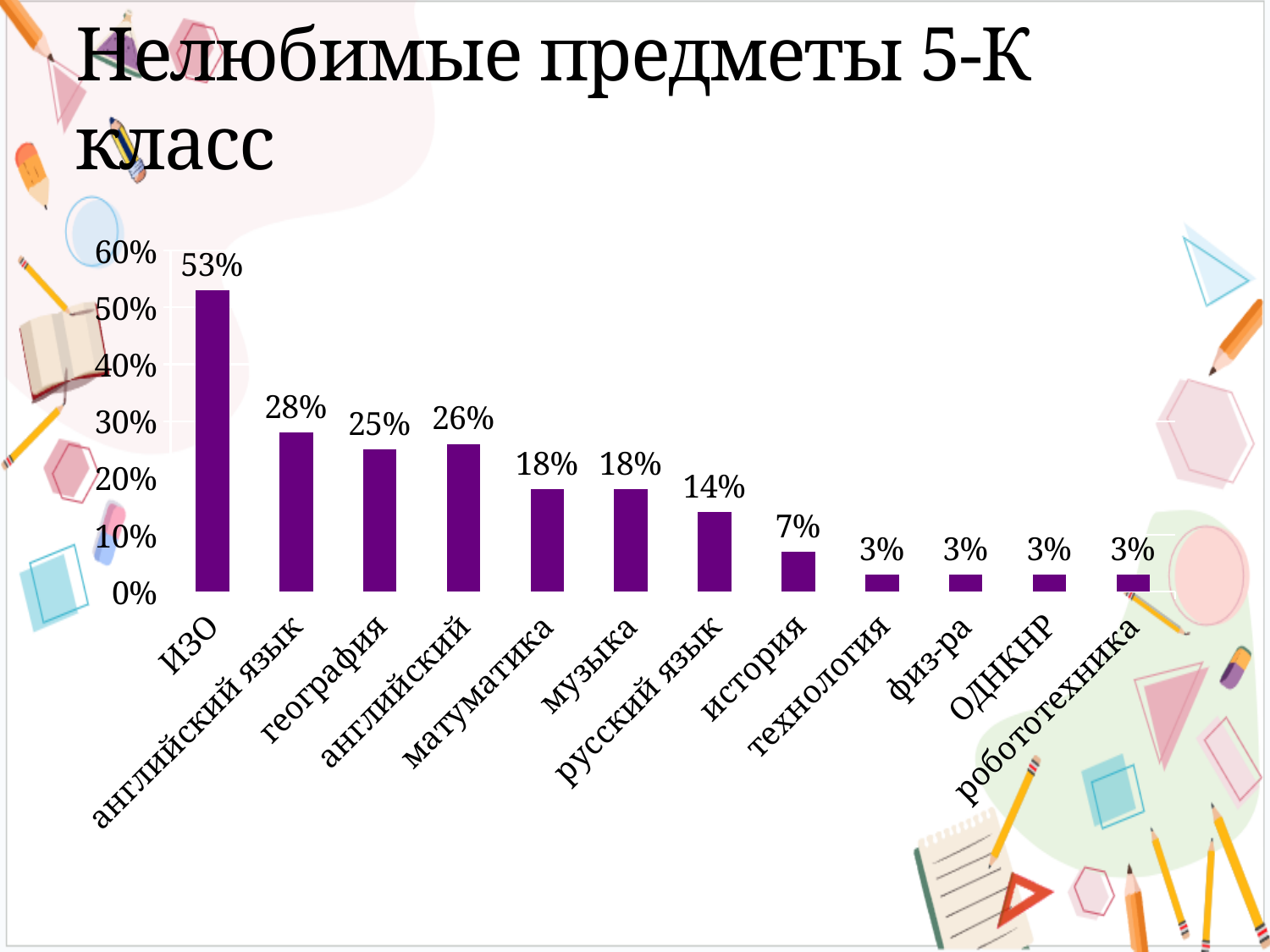
How many categories are shown on the chart? 12 What is the value for история? 7% What is the difference between the values for матуматика and история? 11% What kind of chart is shown on the slide? bar chart What is the title of the chart on the slide? Нелюбимые предметы 5-К класс Is the value for ИЗО greater or less than 50%? greater What is the value for ИЗО? 53% What is the difference between the values for ИЗО and английский язык? 25% What is the value for география? 25% What is the value for русский язык? 14% Which is larger, the value for география or the value for английский? английский Which category has the highest value? ИЗО